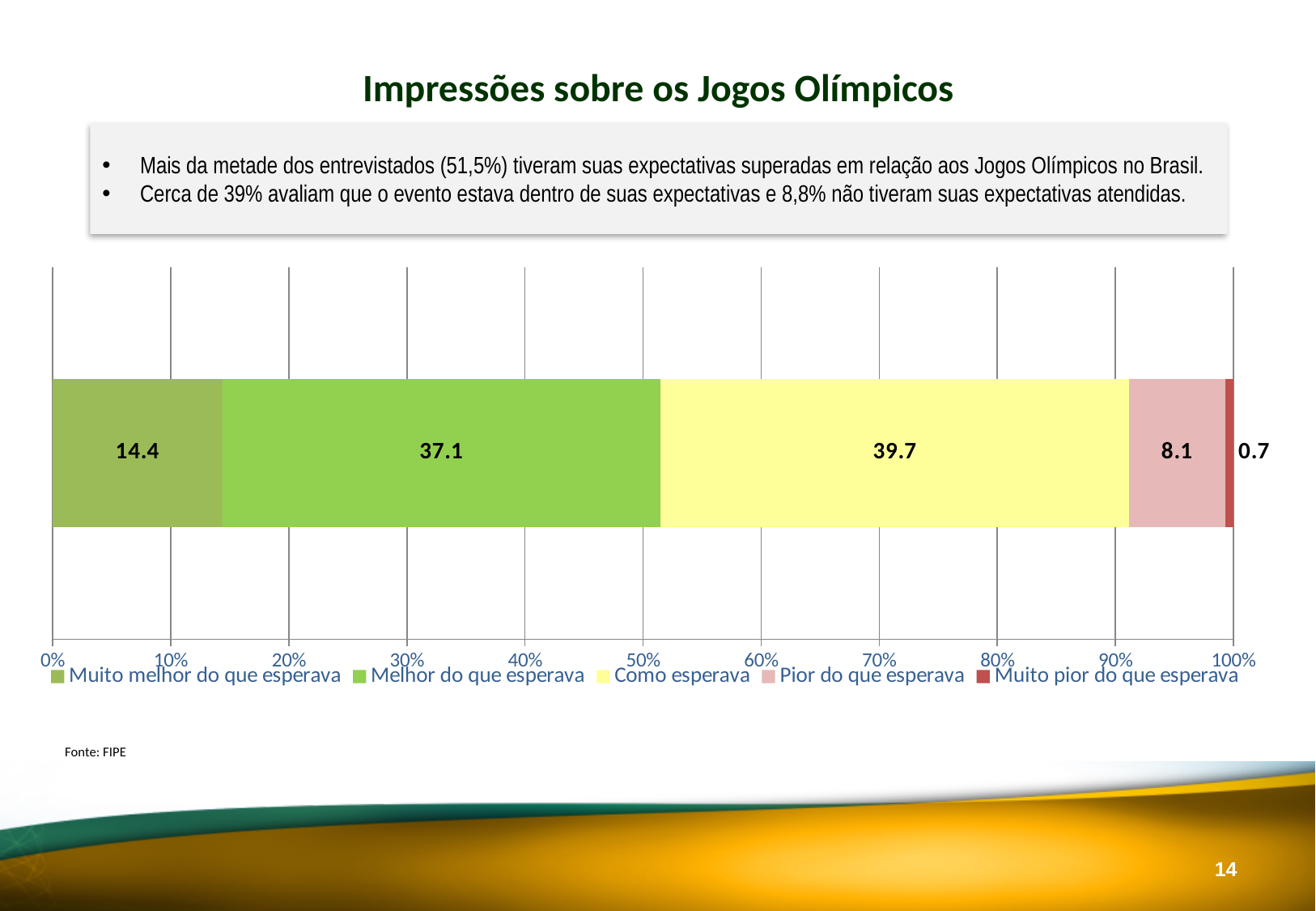
What is the difference between the values for "Como esperava" and "Melhor do que esperava"? 2.6 What is the total of all segments in the stacked bar? 100.0 What is the combined value of "Muito melhor do que esperava" and "Melhor do que esperava"? 51.5 Which is larger, the value for "Muito melhor do que esperava" or the value for "Pior do que esperava"? Muito melhor do que esperava What is the value for "Muito pior do que esperava"? 0.7 What is the value for "Como esperava"? 39.7 What is the value for "Melhor do que esperava"? 37.1 What is the value for "Pior do que esperava"? 8.1 How many series does the legend list? 5 Which series has the smallest segment in the stacked bar? Muito pior do que esperava Which series has the largest segment in the stacked bar? Como esperava What kind of chart is shown on the slide? Stacked bar chart